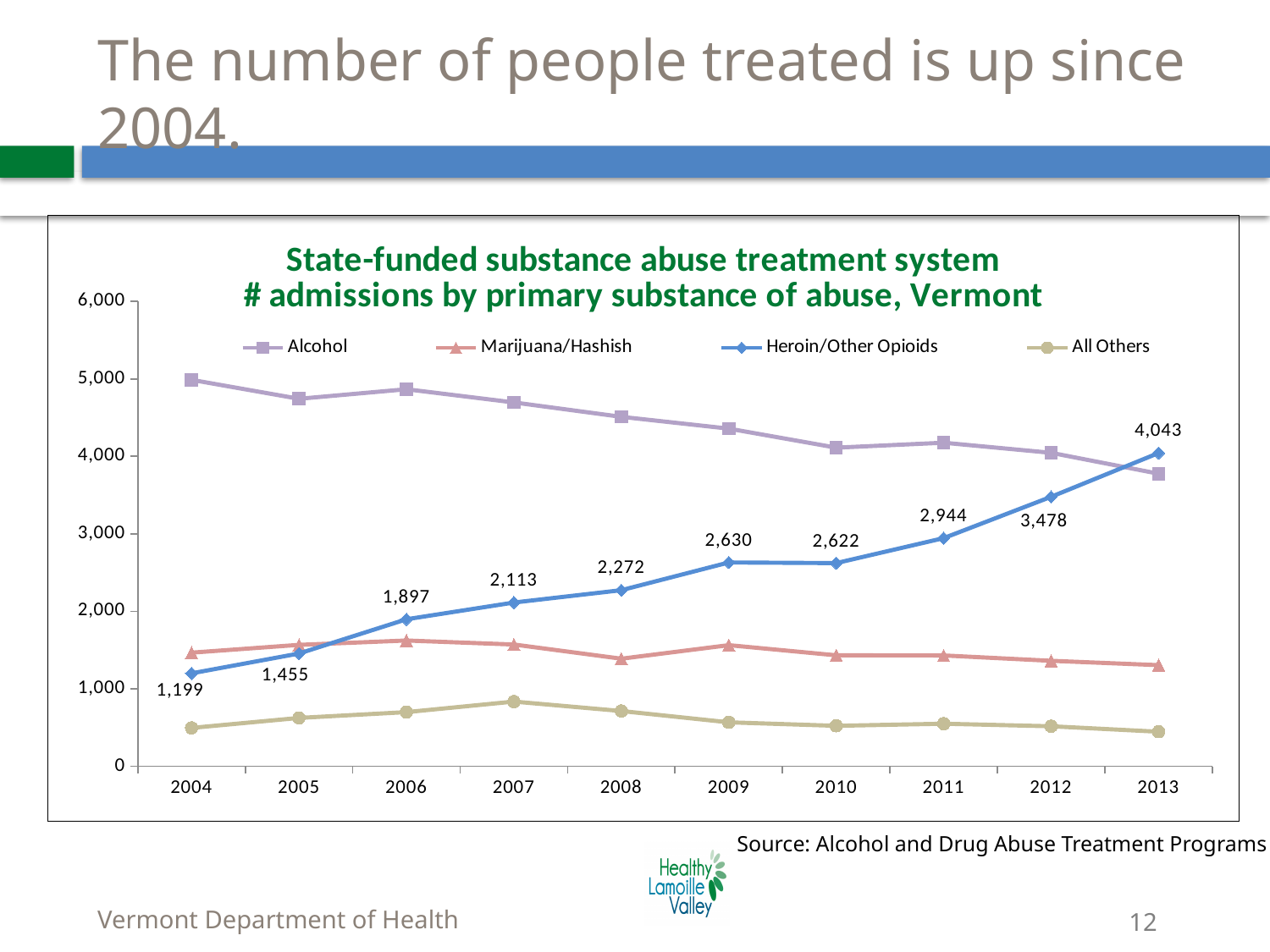
What was the number of Heroin/Other Opioids admissions in 2004? 1,199 Do Alcohol admissions rise or fall from 2004 to 2013? fall In which year were Heroin/Other Opioids admissions highest? 2013 How many series does the legend list? 4 By how much did Heroin/Other Opioids admissions increase from 2012 to 2013? 565 What was the number of Heroin/Other Opioids admissions in 2011? 2,944 How many years are plotted along the x axis? 10 In which year were Heroin/Other Opioids admissions lowest? 2004 Which was larger in 2013: Alcohol admissions or Heroin/Other Opioids admissions? Heroin/Other Opioids What was the number of Heroin/Other Opioids admissions in 2013? 4,043 Is the value for Alcohol in 2004 greater or less than 4,000? greater What kind of chart is shown on the slide? line chart